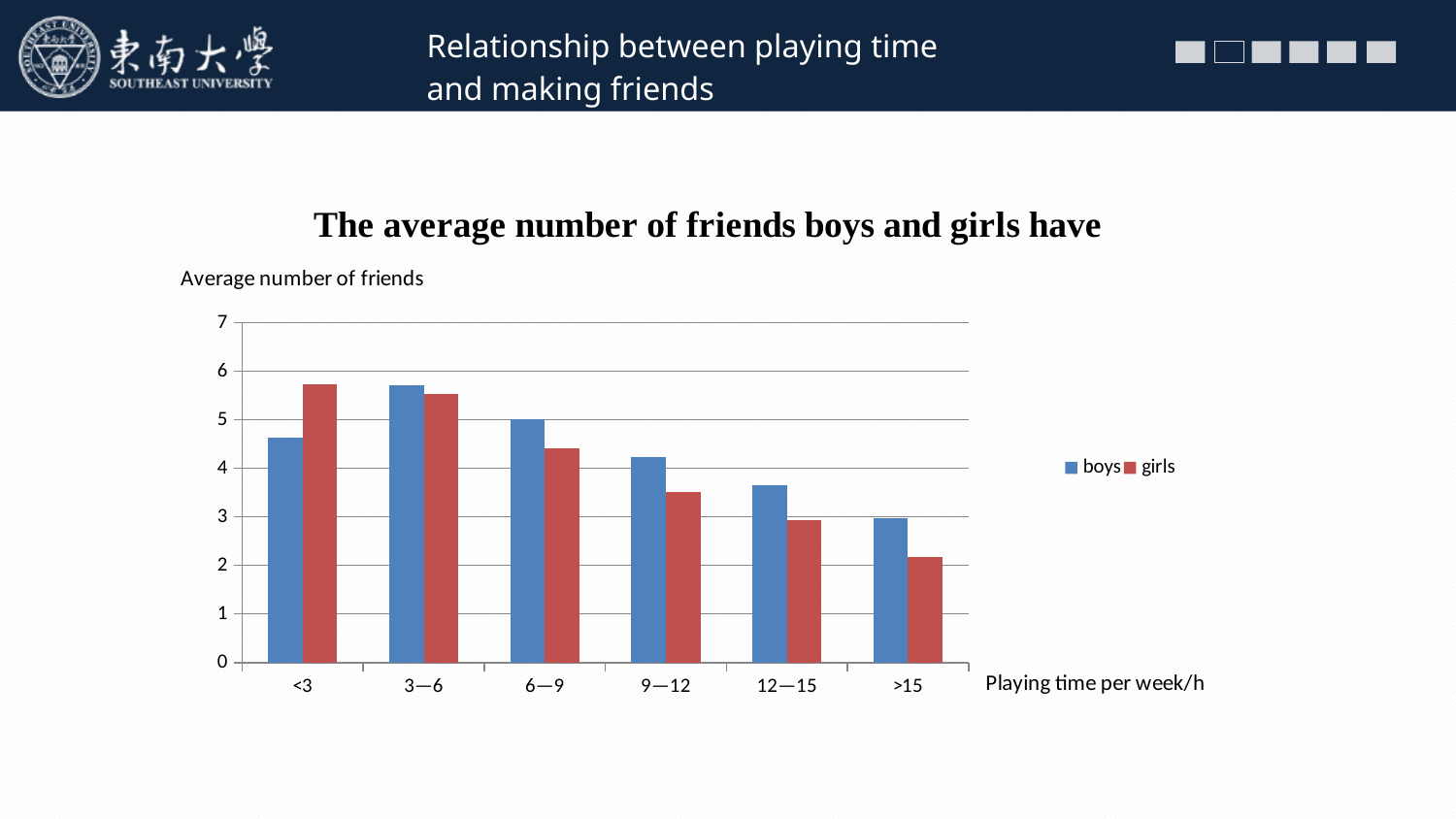
Is the value for girls in the >15 category greater or less than 3? less In the <3 category, which is larger, the value for boys or the value for girls? girls What kind of chart is shown on the slide? bar chart For which playing-time category is the value for girls lowest? >15 How many series does the legend list? 2 From the 3—6 category onward, do the values for girls rise or fall as playing time increases? fall For which playing-time category is the value for boys highest? 3—6 What is the label of the x axis? Playing time per week/h Is the value for boys in the 3—6 category greater or less than 5? greater In the 6—9 category, which is larger, the value for boys or the value for girls? boys For which playing-time category is the value for girls highest? <3 How many playing-time categories are shown on the x axis? 6